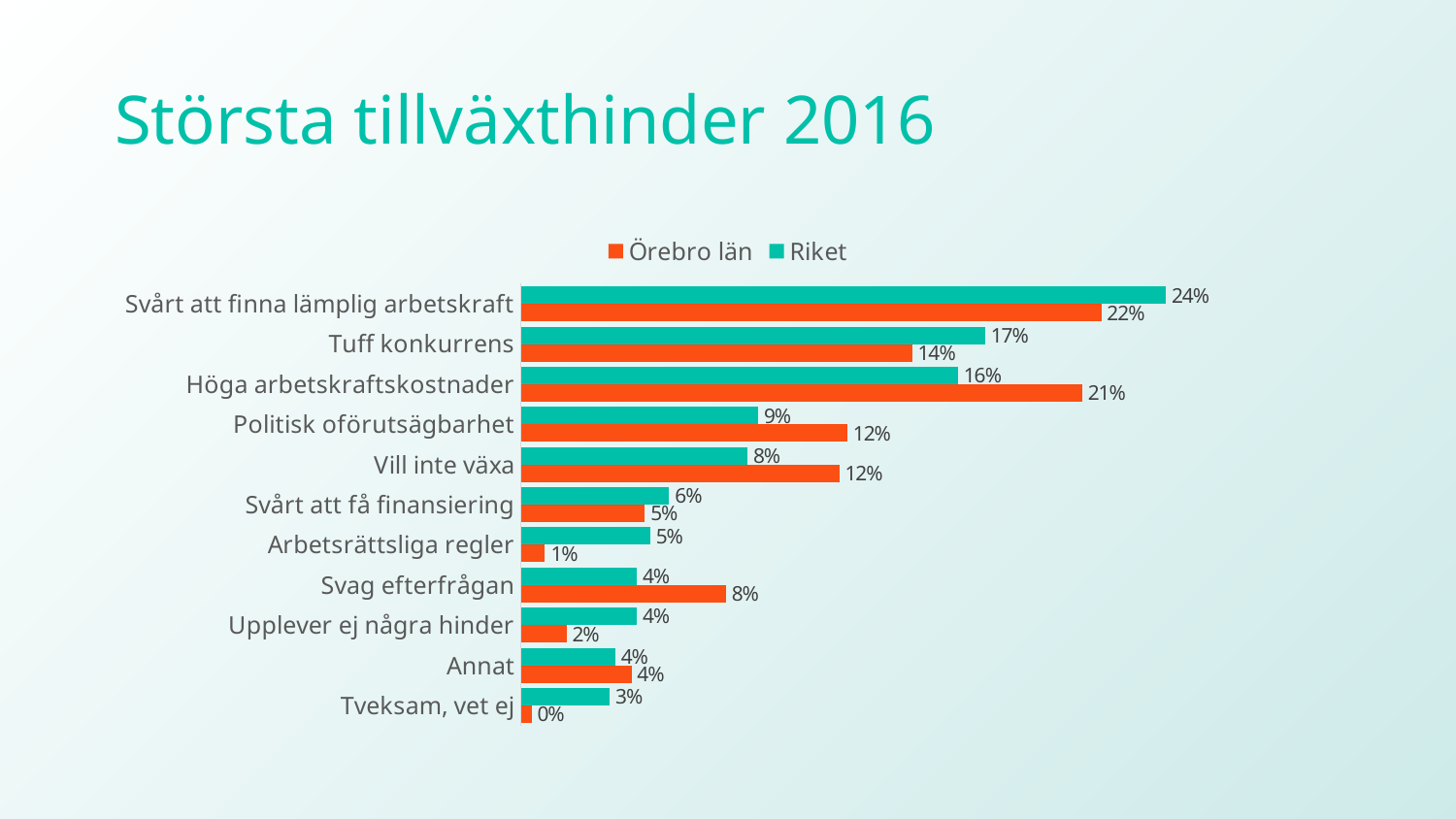
What is the difference between Örebro län and Riket for 'Höga arbetskraftskostnader'? 5% How many categories are shown on the chart? 11 Which category has the highest value for Riket? Svårt att finna lämplig arbetskraft What is the value for Riket for 'Svårt att finna lämplig arbetskraft'? 24% What kind of chart is shown on the slide? Bar chart What is the value for Örebro län for 'Höga arbetskraftskostnader'? 21% Which category has the lowest value for Örebro län? Tveksam, vet ej What is the title of the slide? Största tillväxthinder 2016 How many series does the legend list? 2 Which is larger for 'Svag efterfrågan', Örebro län or Riket? Örebro län Which is larger for 'Tuff konkurrens', Örebro län or Riket? Riket What is the value for Örebro län for 'Arbetsrättsliga regler'? 1%